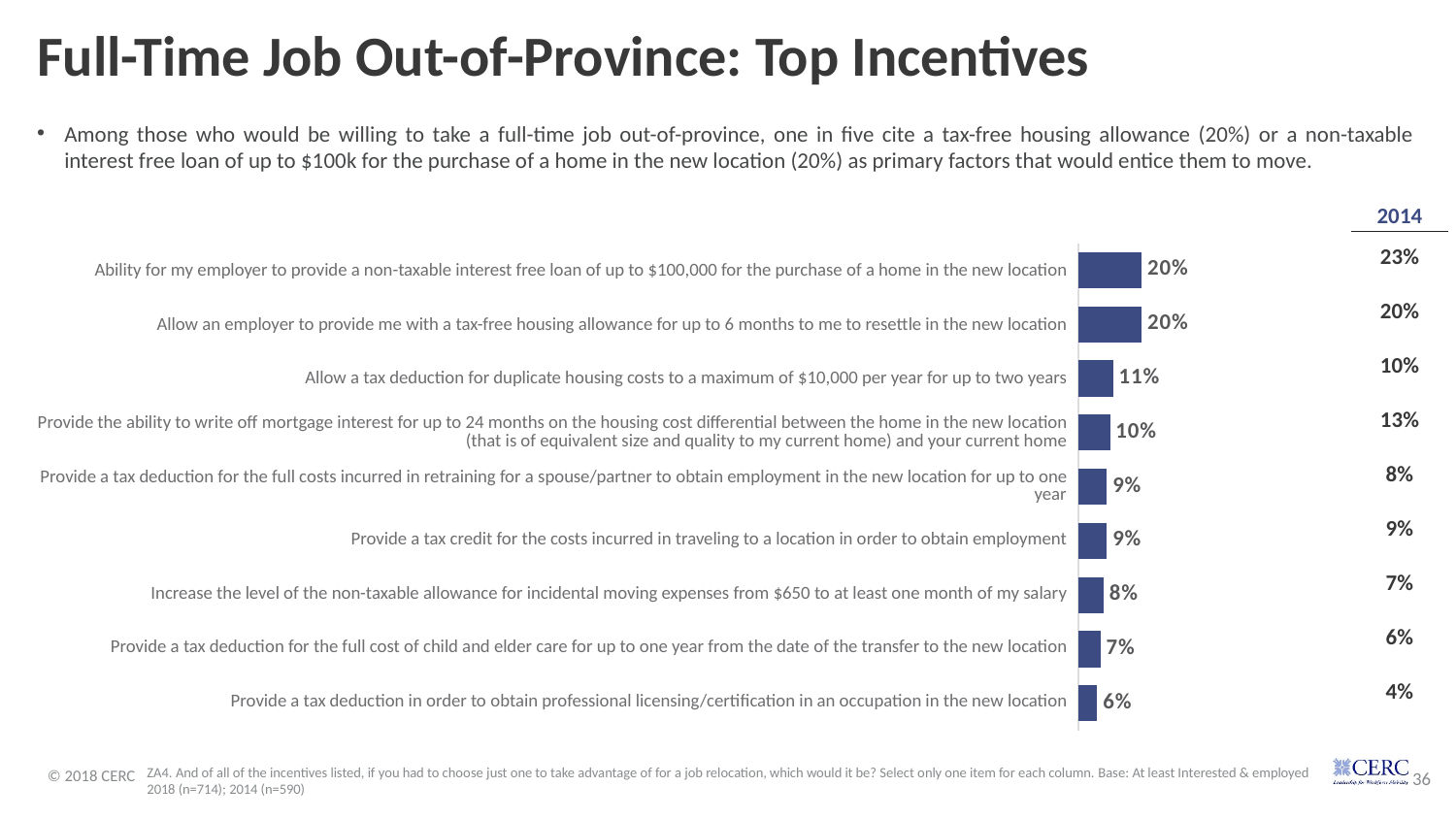
What year is shown as the column header for the comparison values to the right of the chart? 2014 What is the highest value shown in the chart? 20% What type of chart is shown on the slide? Bar chart Which is larger: the value for the tax deduction for duplicate housing costs or the value for the tax credit for costs incurred in traveling to a location to obtain employment? Tax deduction for duplicate housing costs What is the value for 'Increase the level of the non-taxable allowance for incidental moving expenses from $650 to at least one month of my salary'? 8% What is the value for 'Allow a tax deduction for duplicate housing costs to a maximum of $10,000 per year for up to two years'? 11% What is the difference between the value for the non-taxable interest free loan of up to $100,000 (20%) and the value for professional licensing/certification (6%)? 14 percentage points How many incentive categories are plotted in the chart? 9 What is the value for 'Provide a tax deduction for the full cost of child and elder care for up to one year from the date of the transfer to the new location'? 7% Which incentive has the lowest value in the chart? Provide a tax deduction in order to obtain professional licensing/certification in an occupation in the new location Do the bar values increase or decrease going from the top of the chart to the bottom? Decrease What is the value for 'Provide the ability to write off mortgage interest for up to 24 months on the housing cost differential'? 10%